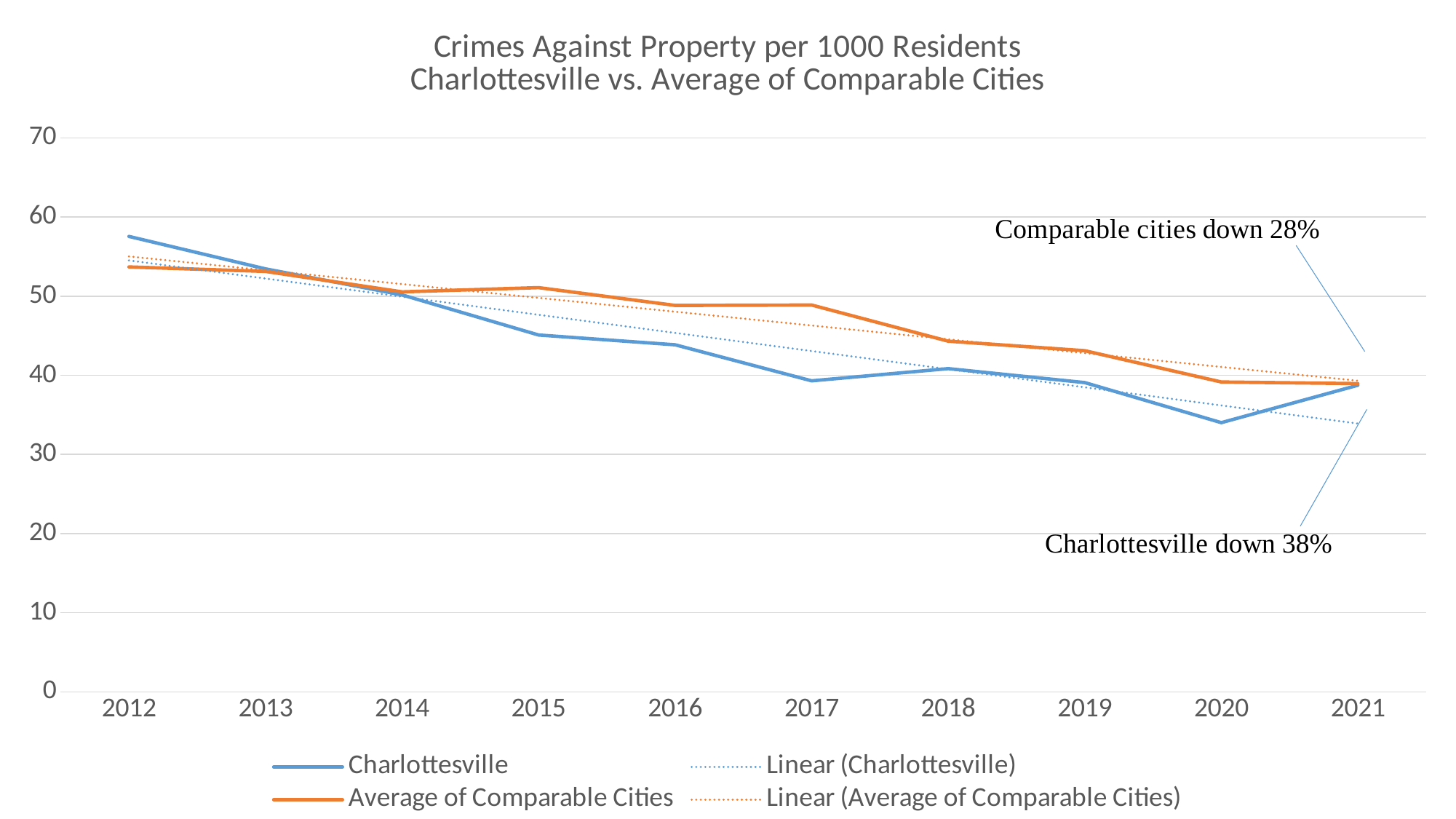
In 2012, which is larger: Charlottesville or Average of Comparable Cities? Charlottesville Is the Charlottesville value for 2012 greater or less than 50? greater Do the Charlottesville values generally rise or fall from 2012 to 2021? Fall How many years are plotted along the x axis? 10 How many entries does the legend list? 4 Is the Average of Comparable Cities value for 2018 greater or less than 50? less In 2015, which is larger: Charlottesville or Average of Comparable Cities? Average of Comparable Cities In which year is the Charlottesville value highest? 2012 According to the annotation on the chart, by what percentage is Charlottesville down? 38% In which year is the Charlottesville value lowest? 2020 Is the Charlottesville value for 2020 greater or less than 40? less What kind of chart is shown on the slide? Line chart